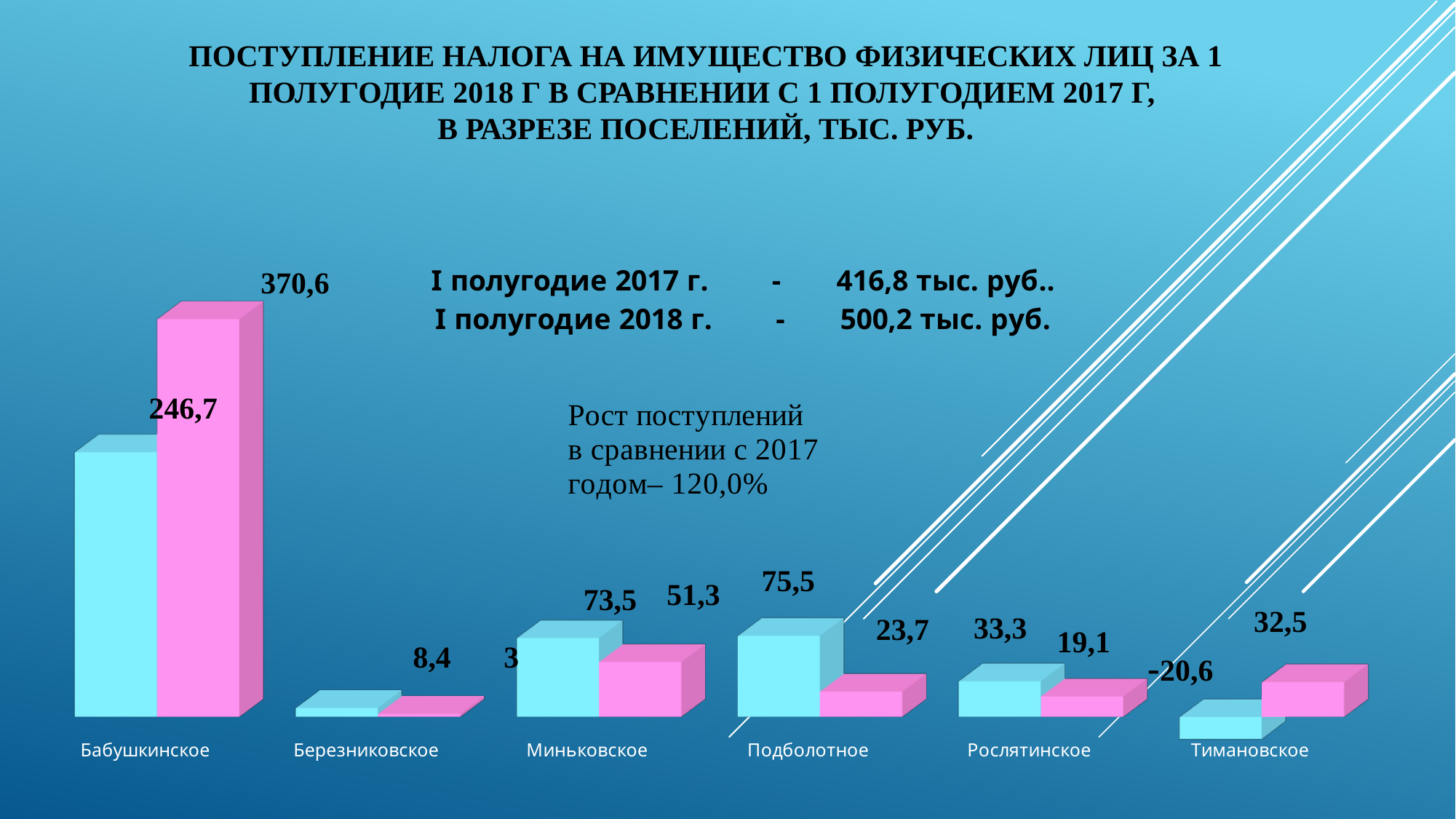
What is the value of the pink bar for Рослятинское? 19,1 How many settlements (categories) are shown on the x axis of the chart? 6 What is the value of the light blue bar for Бабушкинское? 246,7 What is the value of the pink bar for Бабушкинское? 370,6 What is the value of the light blue bar for Подболотное? 75,5 Which settlement has the lowest (negative) bar value in the chart? Тимановское What is the difference between the pink and light blue bars for Бабушкинское? 123,9 For Миньковское, which bar is larger: the light blue bar or the pink bar? the light blue bar What is the value of the pink bar for Тимановское? 32,5 What is the difference between the light blue and pink bars for Подболотное? 51,8 Which settlement has the highest bar in the chart? Бабушкинское What kind of chart is shown on the slide? bar chart